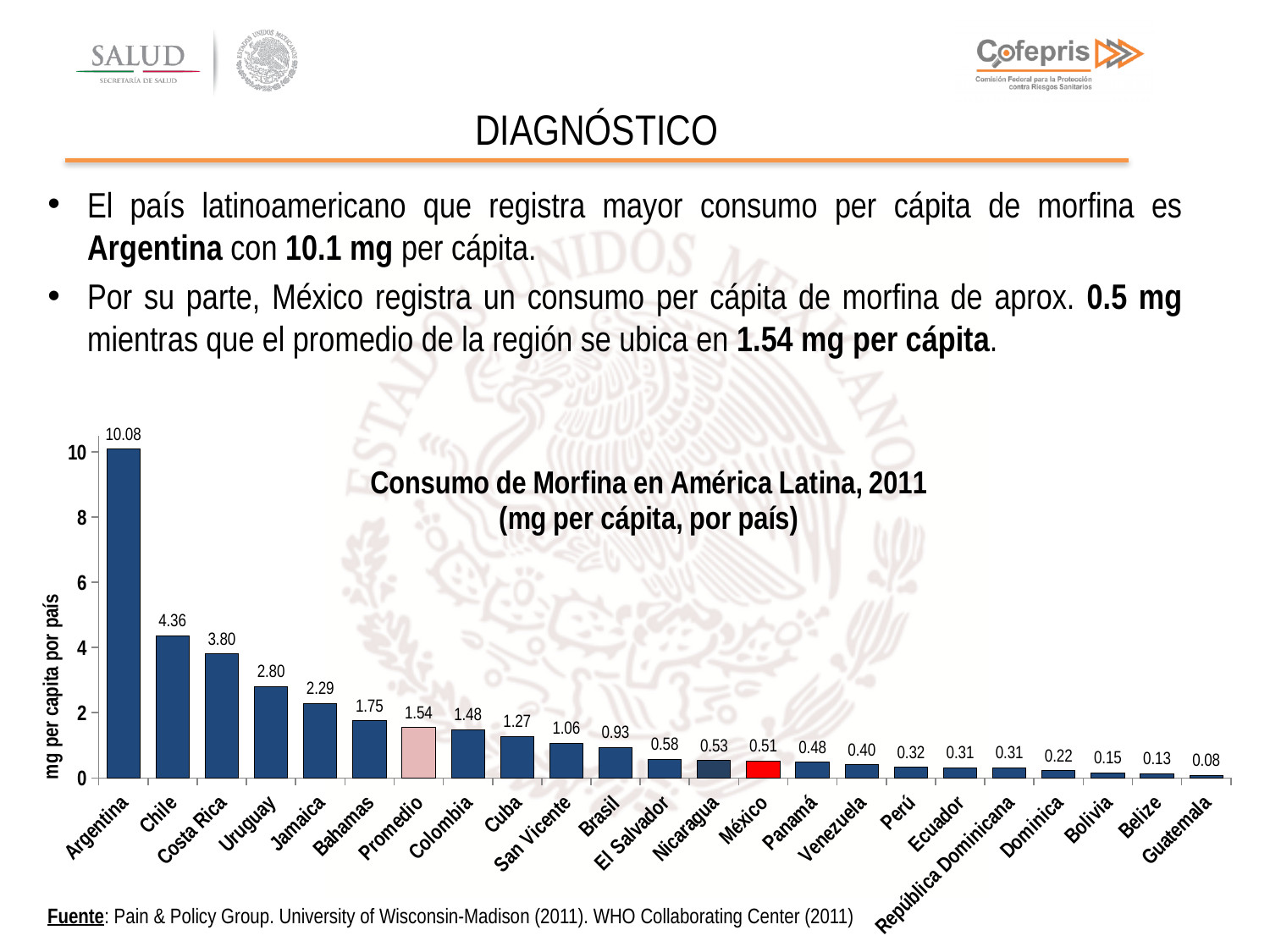
What colour is the bar for México? Red What is the difference between the Promedio value and the value for México? 1.03 What value is shown for Colombia? 1.48 Which country has the lowest value in the chart? Guatemala What type of chart is shown on the slide? Bar chart What is the difference between the values for Chile and Costa Rica? 0.56 Which country has the highest morphine consumption per capita in the chart? Argentina Which has a higher value, Uruguay or Jamaica? Uruguay What value is shown for México in the chart? 0.51 What is the morphine consumption value shown for Argentina? 10.08 How many bars are plotted in the chart? 23 What value is shown for the Promedio bar? 1.54